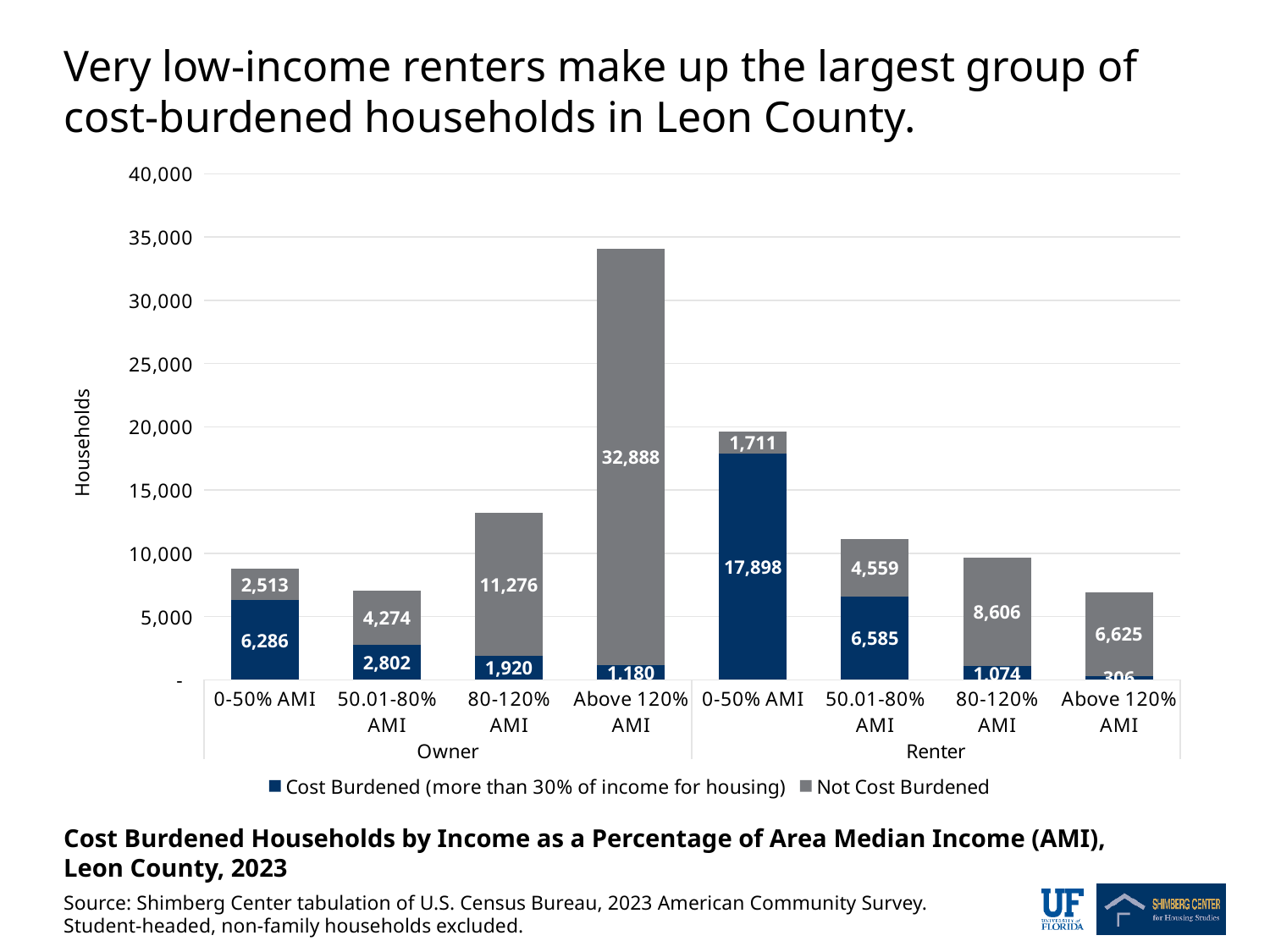
For owner households at 50.01-80% AMI, which is larger: the cost-burdened value or the not cost-burdened value? Not Cost Burdened Which category has the lowest number of not cost-burdened households? Renter, 0-50% AMI What is the number of cost-burdened renter households at 0-50% AMI? 17,898 Which category has the highest number of cost-burdened households? Renter, 0-50% AMI How many series does the legend list? 2 Is the total height of the bar for owner households above 120% AMI greater or less than 30,000? greater What is the difference between cost-burdened renter households at 0-50% AMI and cost-burdened owner households at 0-50% AMI? 11,612 How many income categories (bars) are plotted in the chart? 8 What is the number of not cost-burdened owner households above 120% AMI? 32,888 What is the total number of owner households at 0-50% AMI (cost burdened plus not cost burdened)? 8,799 What is the number of cost-burdened owner households at 80-120% AMI? 1,920 What kind of chart is shown on the slide? Stacked bar chart